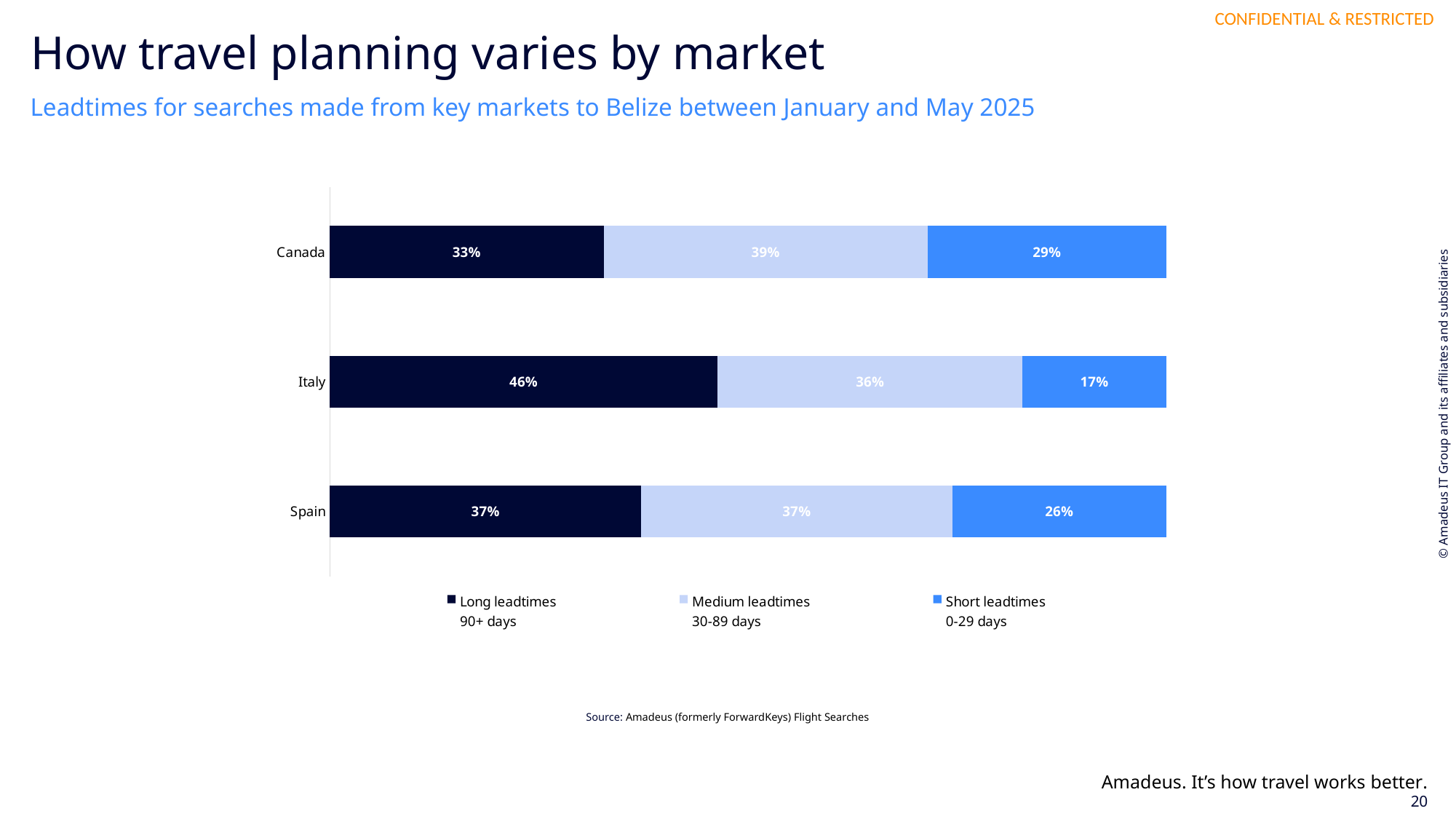
Which leadtime category is shown in the darkest colour in the legend? Long leadtimes 90+ days What share of searches from Italy have short leadtimes (0-29 days)? 17% How many markets are shown in the chart? 3 What is the total of the three segments for the Italy bar? 99% What share of searches from Spain have medium leadtimes (30-89 days)? 37% What is the difference in percentage points between the long leadtime share for Italy and for Canada? 13 How many series does the legend list? 3 Which market has the highest share of long leadtimes (90+ days)? Italy Which is larger: the short leadtime share for Canada or for Spain? Canada What share of searches from Canada have long leadtimes (90+ days)? 33% Which market has the lowest share of short leadtimes (0-29 days)? Italy What kind of chart is shown on the slide? Stacked bar chart